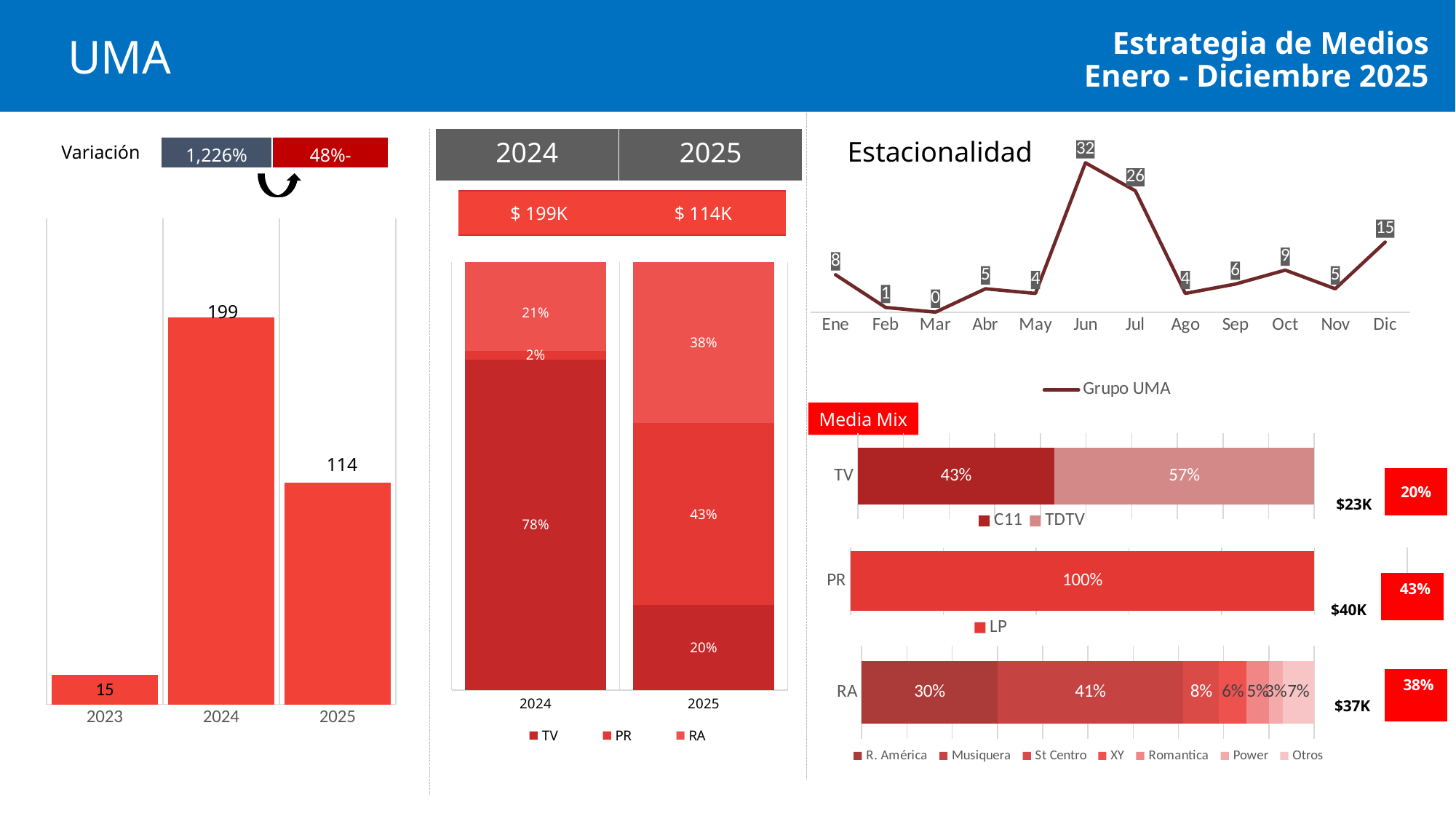
What kind of chart is the Estacionalidad chart? Line chart In the left bar chart, which year has the lowest value? 2023 In the left bar chart, what is the difference between the values for 2024 and 2025? 85 In the Estacionalidad chart, which month has the highest value? Jun In the Media Mix chart, which is larger in the TV bar, C11 or TDTV? TDTV In the Estacionalidad chart, what is the value for Dic? 15 In the Media Mix chart, what share does Musiquera have in the RA bar? 41% In the middle stacked bar chart, what share does PR have in 2025? 43% In the left bar chart, how many years are shown? 3 How many series does the legend of the middle stacked bar chart list? 3 In the middle stacked bar chart, what share does TV have in 2024? 78% In the left bar chart, what is the value for 2024? 199